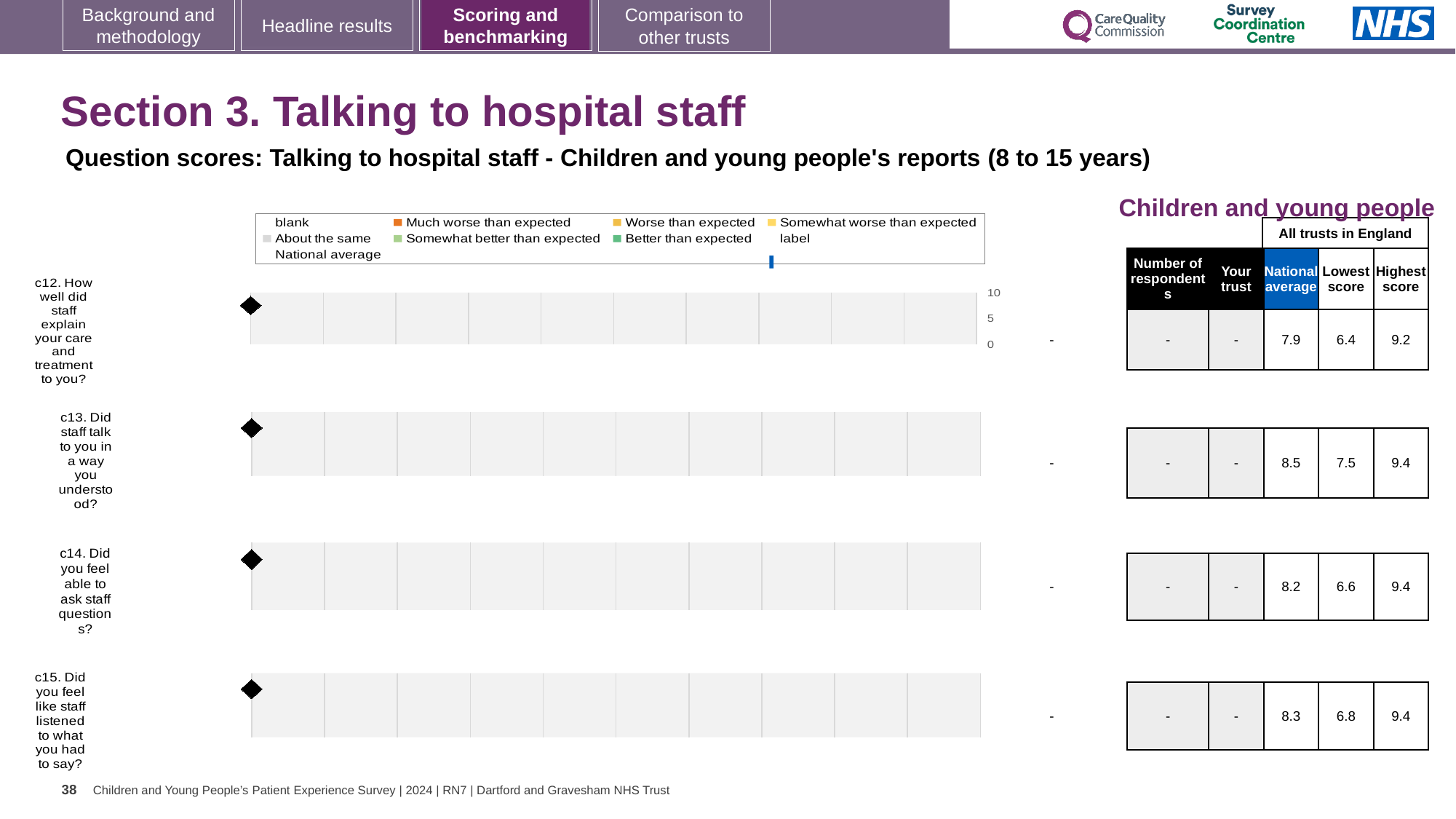
What value is shown for Your trust in the table next to the c12 chart? - Which question (c12 to c15) has the lowest National average score in the table? c12 Which has the larger National average score in the table, c14 or c15? c15 In the table for c13, what is the difference between the Highest score and the Lowest score? 1.9 Which question (c12 to c15) has the highest National average score in the table? c13 In the table next to the c15 chart, what is the National average score? 8.3 In the table next to the c13 chart, what is the Lowest score? 7.5 What kind of chart is used for question c12 on the slide? bar chart In the table next to the c12 chart, what is the National average score? 7.9 In the table next to the c14 chart, what is the Highest score? 9.4 How many question charts (c12 to c15) are shown on the slide? 4 What is the highest tick value shown on the axis of the c12 chart? 10